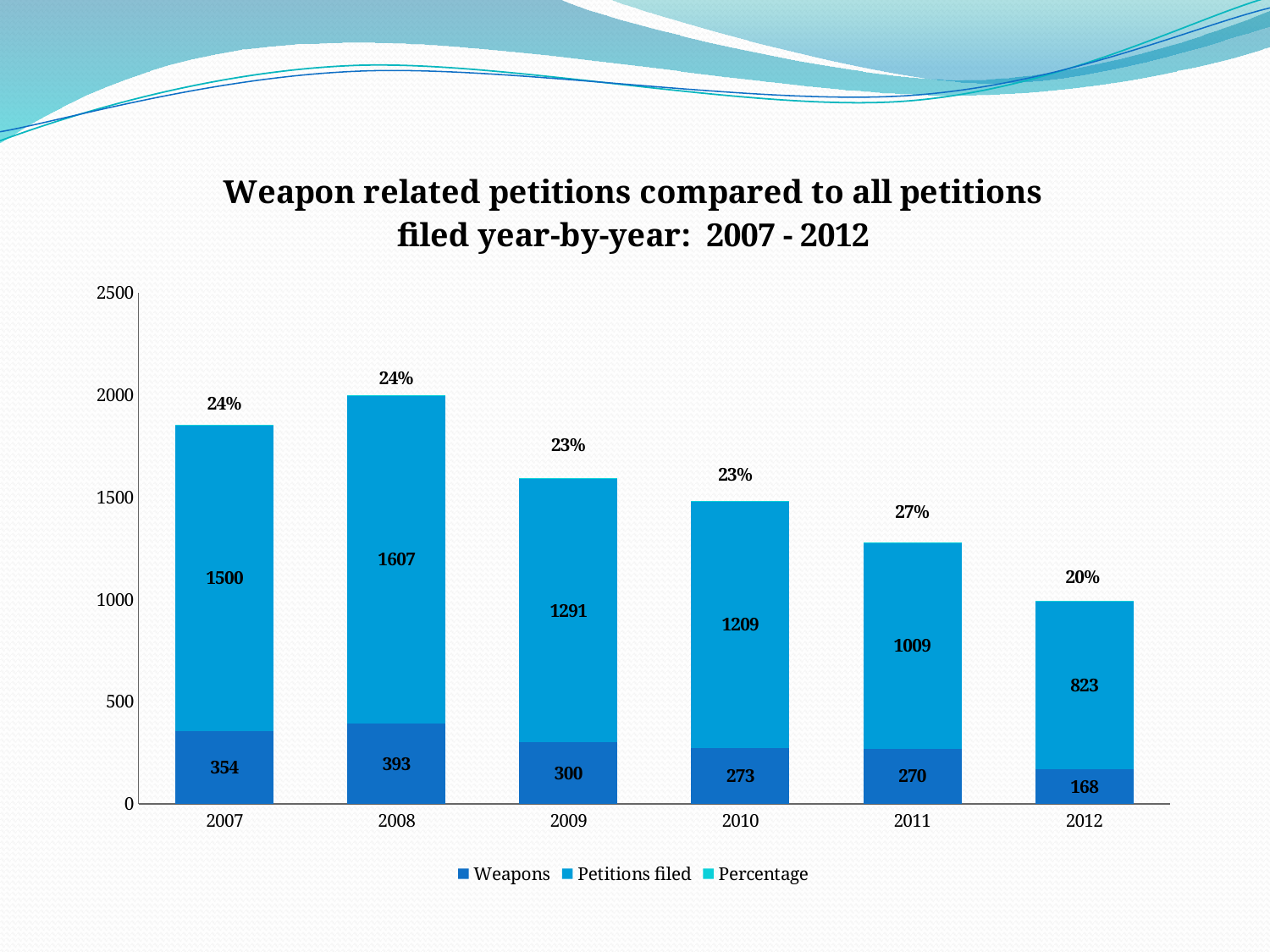
Which year has the highest Petitions filed value? 2008 How many series does the legend list? 3 How many years are shown on the x axis? 6 Which year has the lowest Weapons value? 2012 What is the total of the stacked bar for 2008? 2000 What is the Weapons value for 2008? 393 What percentage is shown above the bar for 2011? 27% What is the total of the stacked bar for 2012? 991 What kind of chart is shown on the slide? Stacked bar chart What is the difference between the Petitions filed values for 2007 and 2012? 677 Which is larger, the Weapons value for 2009 or the Weapons value for 2011? 2009 What is the Petitions filed value for 2010? 1209